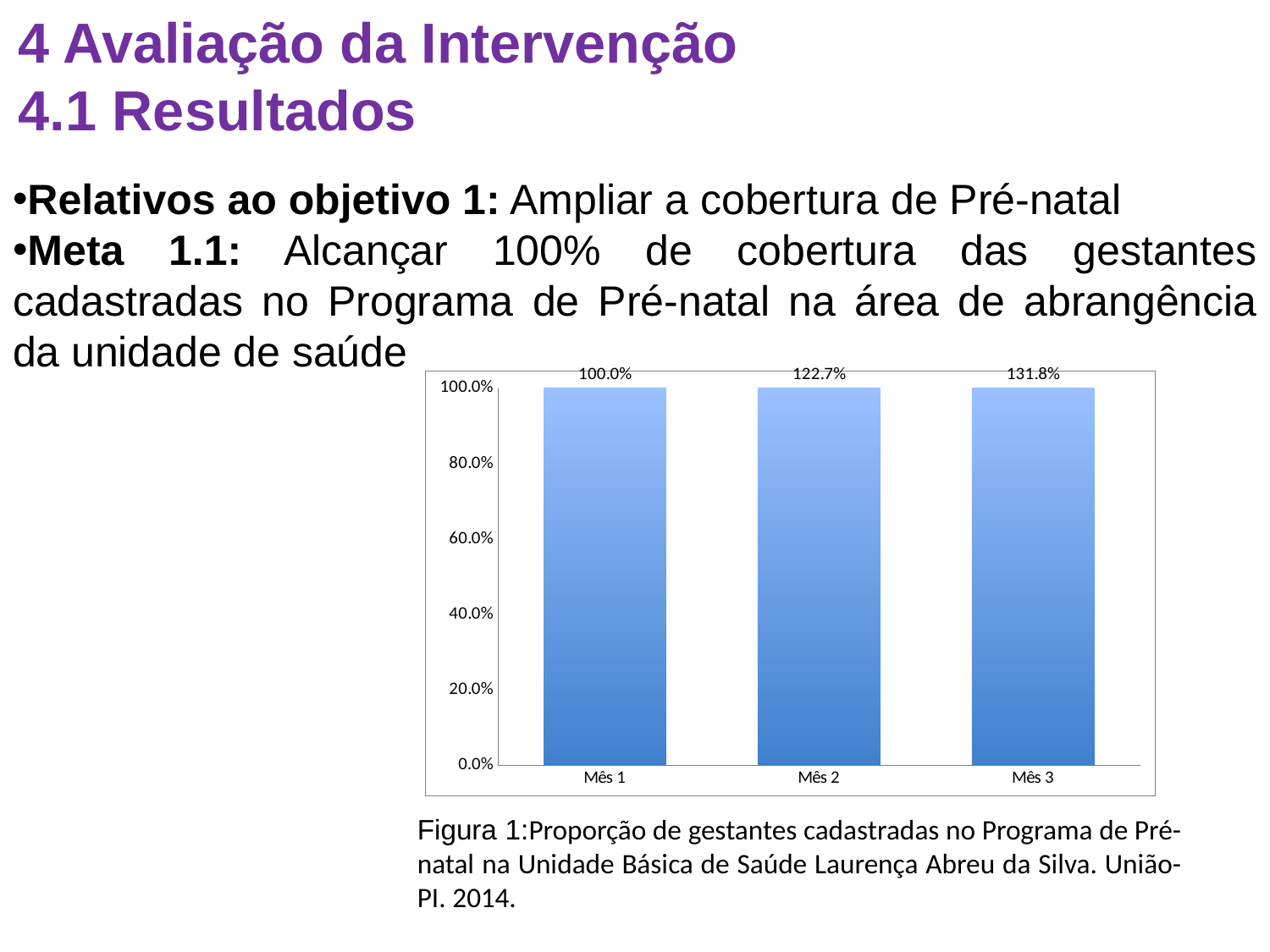
What is the highest tick value shown on the vertical axis? 100.0% What is the difference between the values for Mês 2 and Mês 1? 22.7 percentage points What is the value for Mês 3? 131.8% Do the values rise or fall from Mês 1 to Mês 3? Rise Which is larger, the value for Mês 2 or the value for Mês 3? Mês 3 Which month has the lowest value according to the data labels? Mês 1 Which month has the highest value according to the data labels? Mês 3 What kind of chart is shown on the slide? Bar chart What is the difference between the values for Mês 3 and Mês 1? 31.8 percentage points What is the value for Mês 1? 100.0% What is the value for Mês 2? 122.7% How many months (categories) are shown on the x axis? 3